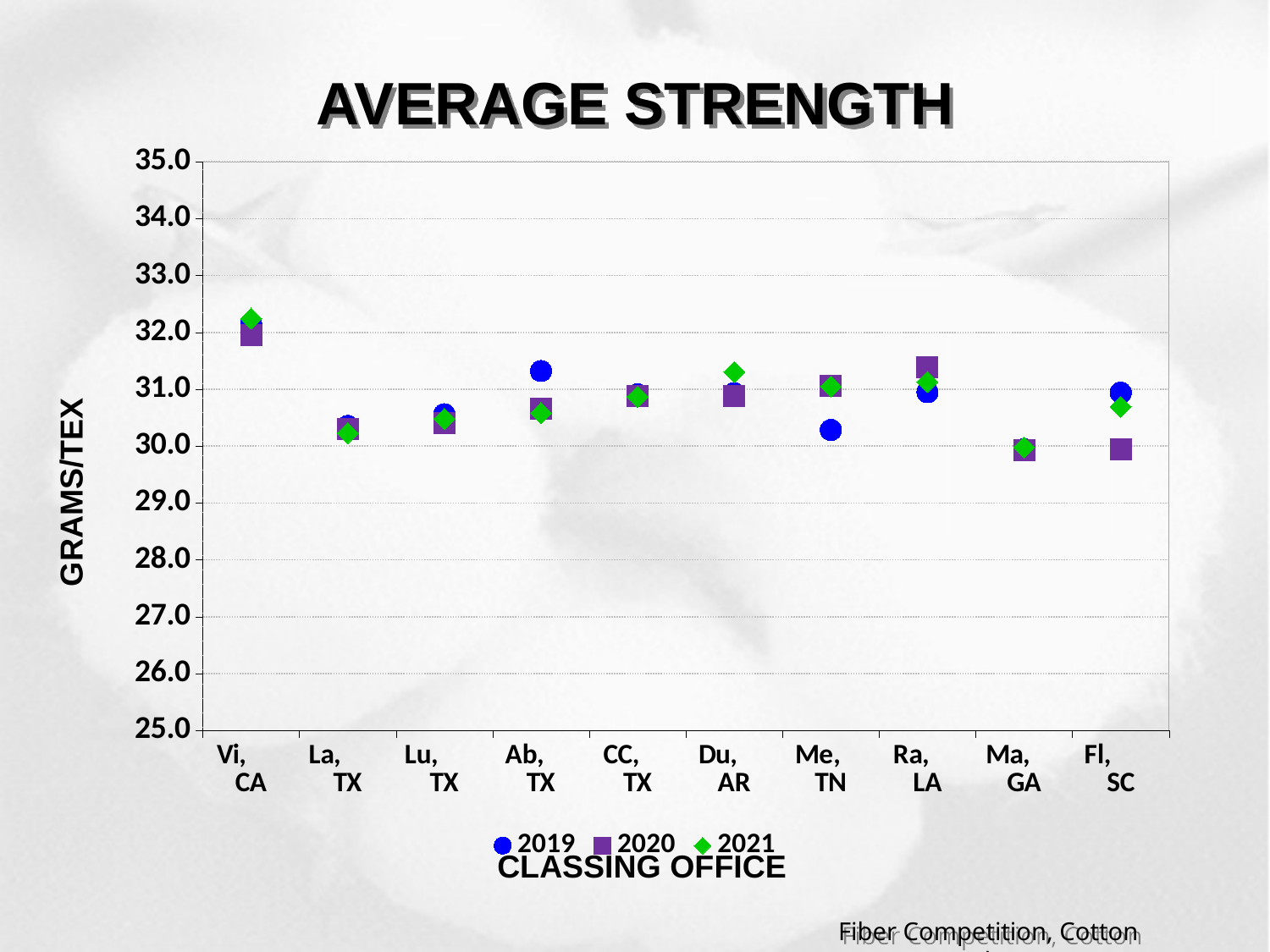
What is the title of the chart? AVERAGE STRENGTH Is the 2020 value for Ra, LA greater or less than 31.0? greater For Ab, TX, which series has the larger value, 2019 or 2020? 2019 Is the 2019 value for Ab, TX greater or less than 31.0? greater What kind of chart is shown on the slide? scatter chart Is the 2020 value for Fl, SC greater or less than 30.5? less How many series does the legend list? 3 Which classing office has the highest 2021 average strength? Vi, CA For Me, TN, which series has the larger value, 2019 or 2020? 2020 How many classing offices are shown on the x axis? 10 What is the label of the vertical axis? GRAMS/TEX